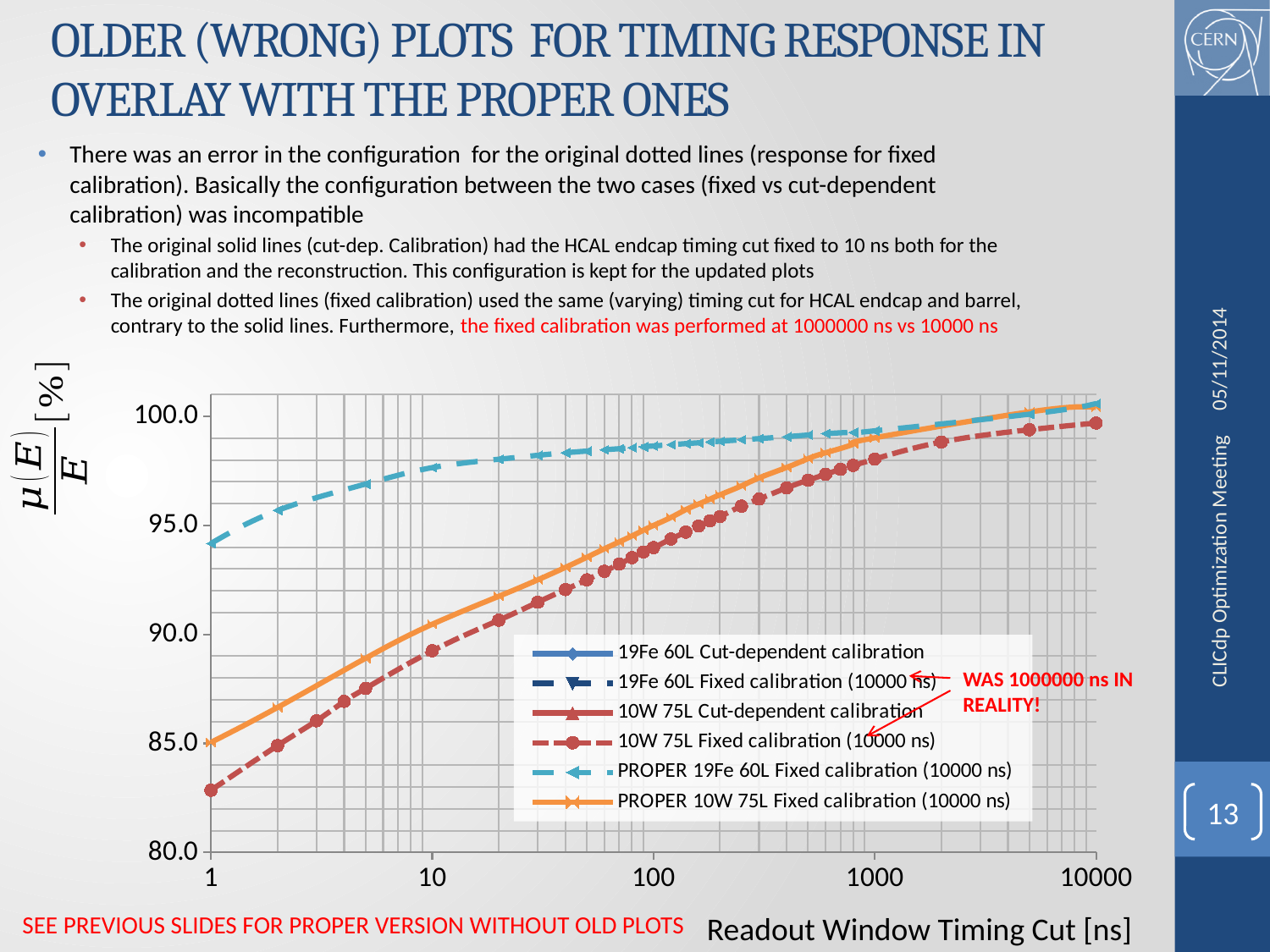
Does the PROPER 19Fe 60L Fixed calibration (10000 ns) series rise or fall as the readout window timing cut increases? rise Does the 10W 75L Fixed calibration (10000 ns) series rise or fall along the x axis? rise How many series does the chart legend list? 6 What kind of chart is shown on the slide? line chart Is the value of the PROPER 19Fe 60L Fixed calibration (10000 ns) series at a timing cut of 1 ns greater or less than 95.0? less Is the value of the PROPER 19Fe 60L Fixed calibration (10000 ns) series at a timing cut of 10 ns greater or less than 95.0? greater At a timing cut of 1 ns, which is higher: the PROPER 19Fe 60L Fixed calibration (10000 ns) series or the PROPER 10W 75L Fixed calibration (10000 ns) series? PROPER 19Fe 60L Fixed calibration (10000 ns) Which series in the legend is drawn in orange? PROPER 10W 75L Fixed calibration (10000 ns) Is the value of the 10W 75L Fixed calibration (10000 ns) series at a timing cut of 1 ns greater or less than 85.0? less What is the x-axis title of the chart? Readout Window Timing Cut [ns]